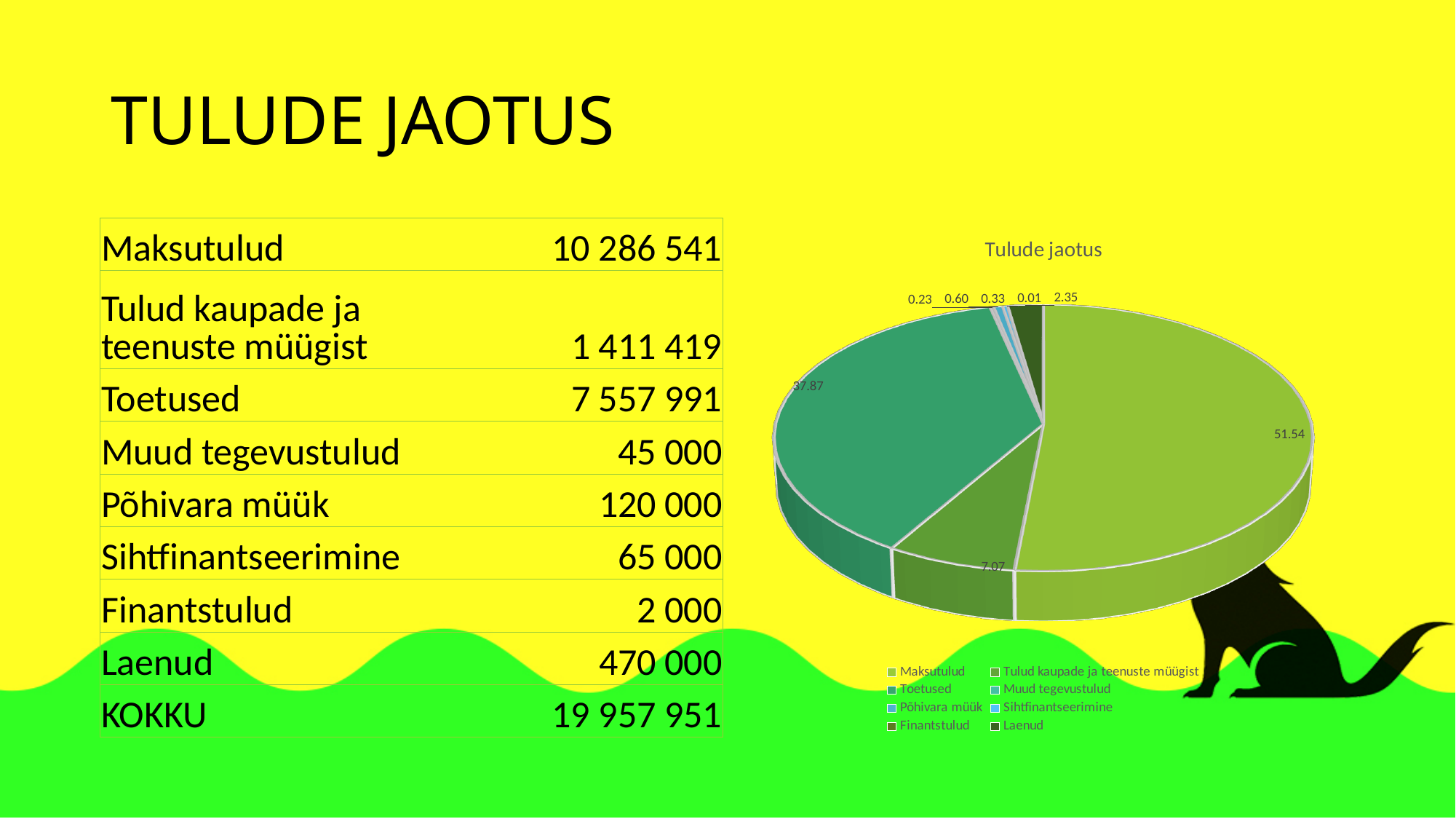
Which category has the largest slice in the pie chart? Maksutulud What value is labelled on the Laenud slice of the pie chart? 2.35 What type of chart is shown on the slide? pie chart Which category has the smallest slice in the pie chart? Finantstulud What is the title of the chart? Tulude jaotus How many categories does the chart's legend list? 8 What is the difference between the labelled values for Maksutulud and Toetused? 13.67 What value is labelled on the Maksutulud slice of the pie chart? 51.54 What value is labelled on the Toetused slice of the pie chart? 37.87 What value is labelled on the Tulud kaupade ja teenuste müügist slice? 7.07 What value is labelled on the Põhivara müük slice of the pie chart? 0.60 Which slice is larger, Toetused or Tulud kaupade ja teenuste müügist? Toetused